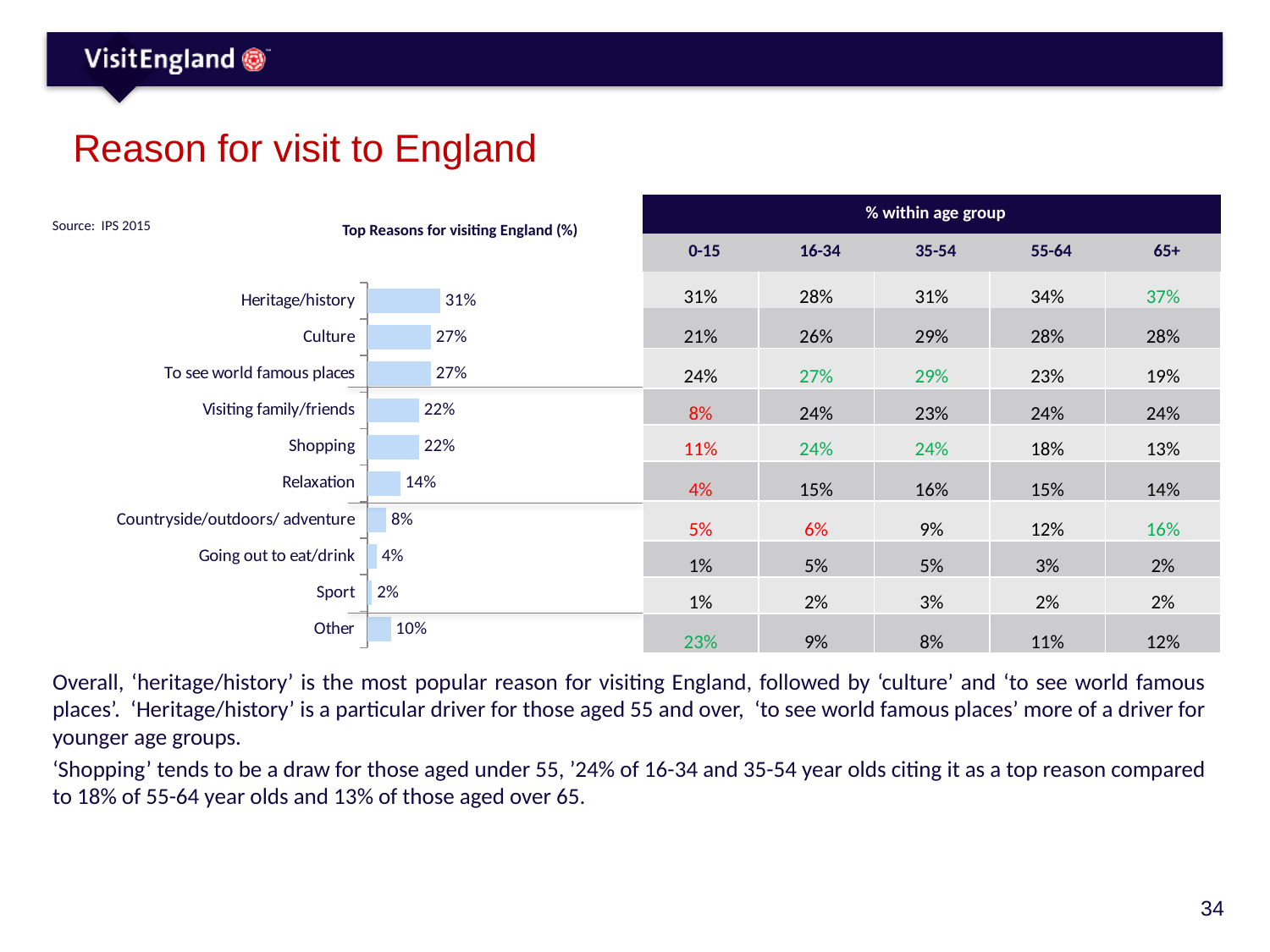
What type of chart is used to show the top reasons for visiting England? Bar chart Which is larger in the Top Reasons for visiting England chart, Relaxation or Other? Relaxation What is the value for Countryside/outdoors/adventure in the Top Reasons for visiting England chart? 8% What is the title of the bar chart on the slide? Top Reasons for visiting England (%) How many reasons are shown in the Top Reasons for visiting England chart? 10 What is the difference between Heritage/history and Culture in the Top Reasons for visiting England chart? 4% What is the difference between Shopping and Going out to eat/drink in the Top Reasons for visiting England chart? 18% What is the value for Other in the Top Reasons for visiting England chart? 10% What is the value for Heritage/history in the Top Reasons for visiting England chart? 31% Which reason has the highest value in the Top Reasons for visiting England chart? Heritage/history Which reason has the lowest value in the Top Reasons for visiting England chart? Sport What is the value for Relaxation in the Top Reasons for visiting England chart? 14%